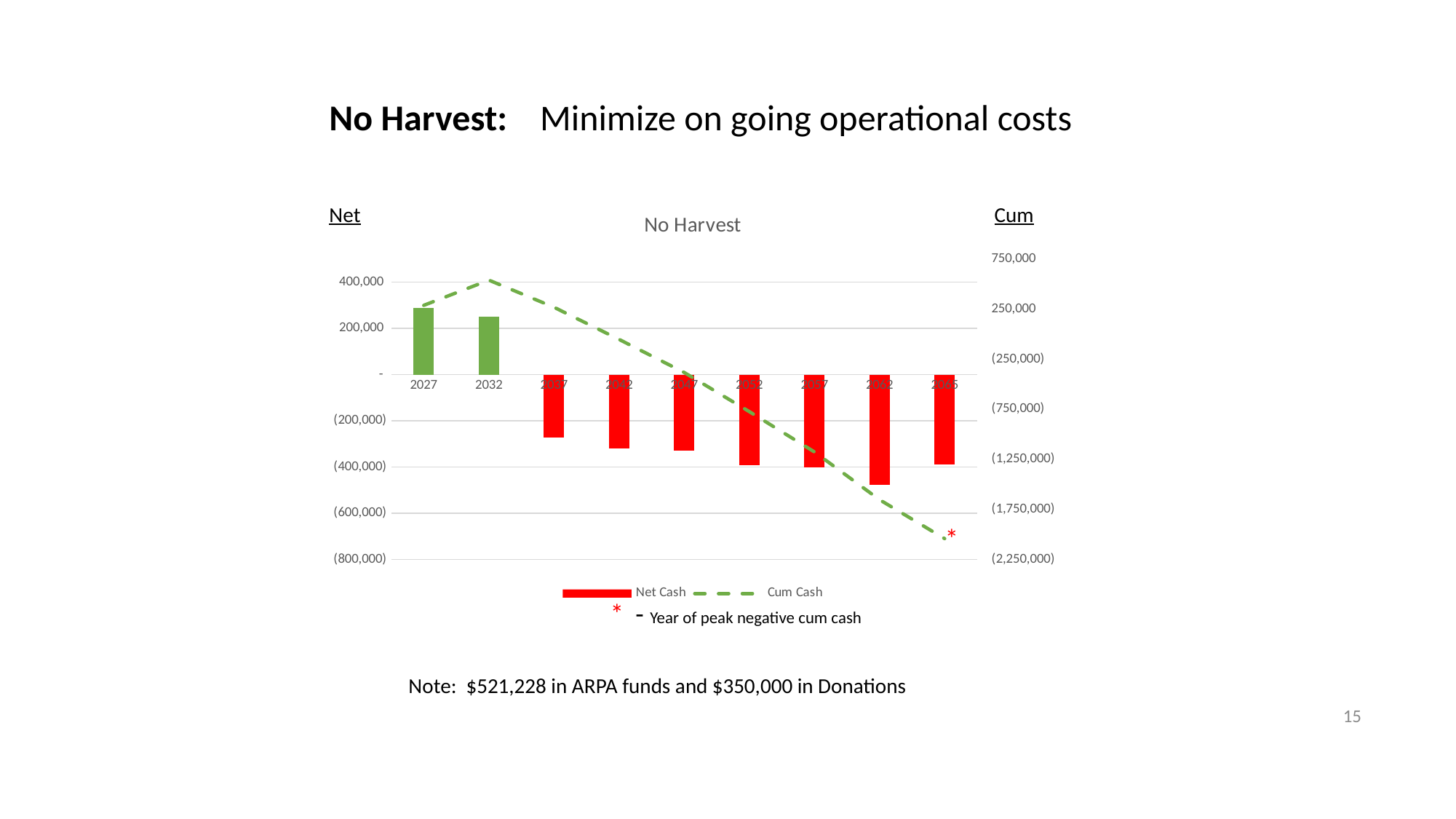
How many years are shown on the x axis of the chart? 9 Which year has the lowest Net Cash bar? 2062 Is the Net Cash value for 2037 greater or less than (200,000)? less Is the Net Cash value for 2027 greater or less than 200,000? greater Which series are listed in the chart legend? Net Cash and Cum Cash Which year has the larger Net Cash value, 2027 or 2032? 2027 What kind of chart is shown on the slide? A combination bar and line chart Is the Net Cash value for 2062 greater or less than (400,000)? less How many series does the chart legend list? 2 Which year has the highest Net Cash bar? 2027 Does the Cum Cash line rise or fall from 2032 to the final year on the x axis? fall What is the title of the chart? No Harvest